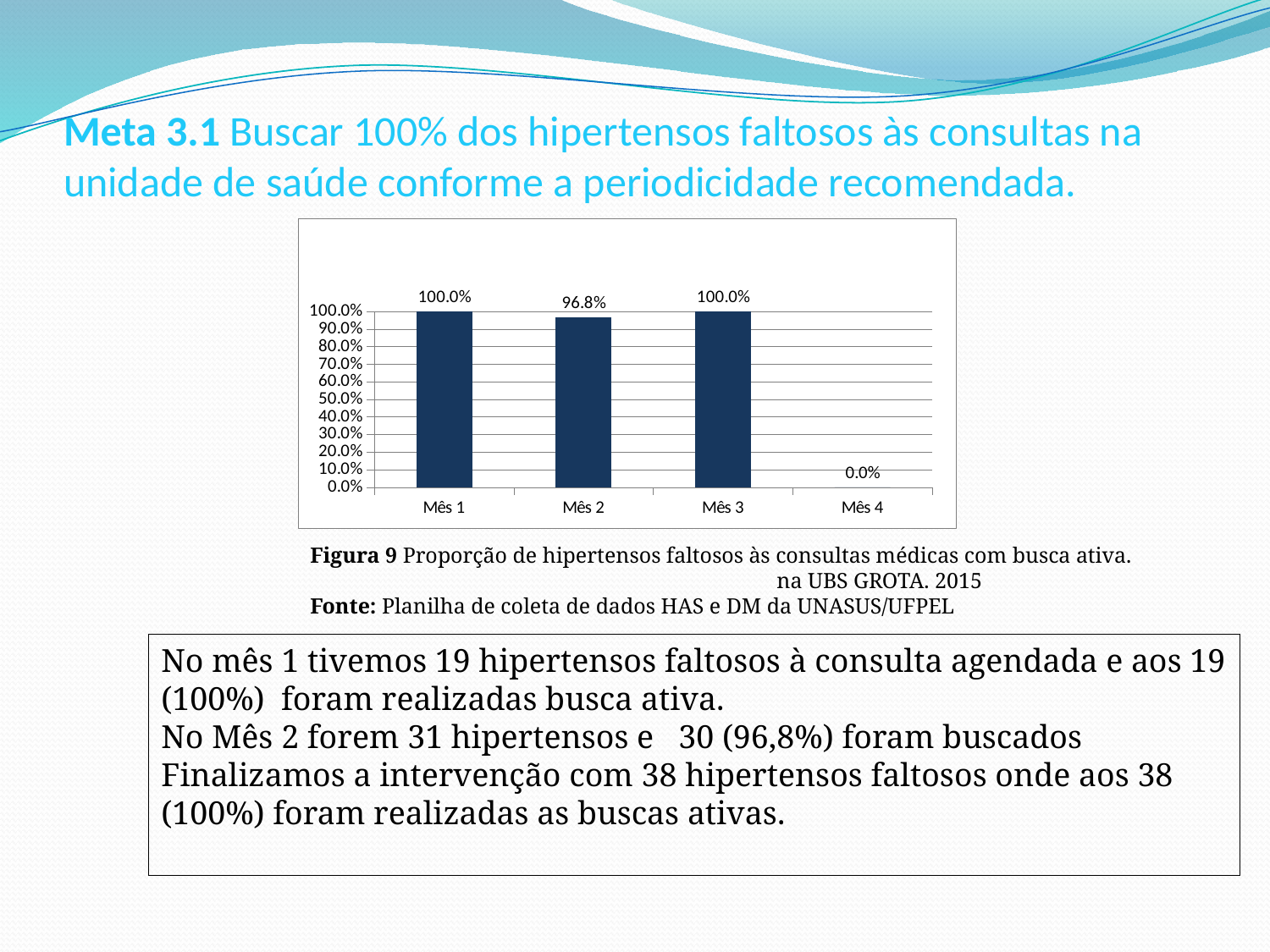
What is the difference between the values for Mês 1 and Mês 2? 3.2% What is the difference between the values for Mês 3 and Mês 4? 100.0% What is the value for Mês 4? 0.0% How many categories are shown on the x axis? 4 What is the value for Mês 1? 100.0% Which is larger, the value for Mês 2 or the value for Mês 3? Mês 3 What kind of chart is shown on the slide? bar chart Is the value for Mês 2 greater or less than 90.0%? greater What is the value for Mês 2? 96.8% Which category has the lowest value? Mês 4 What is the figure number given in the caption below the chart? Figura 9 What is the highest value shown on the y axis? 100.0%